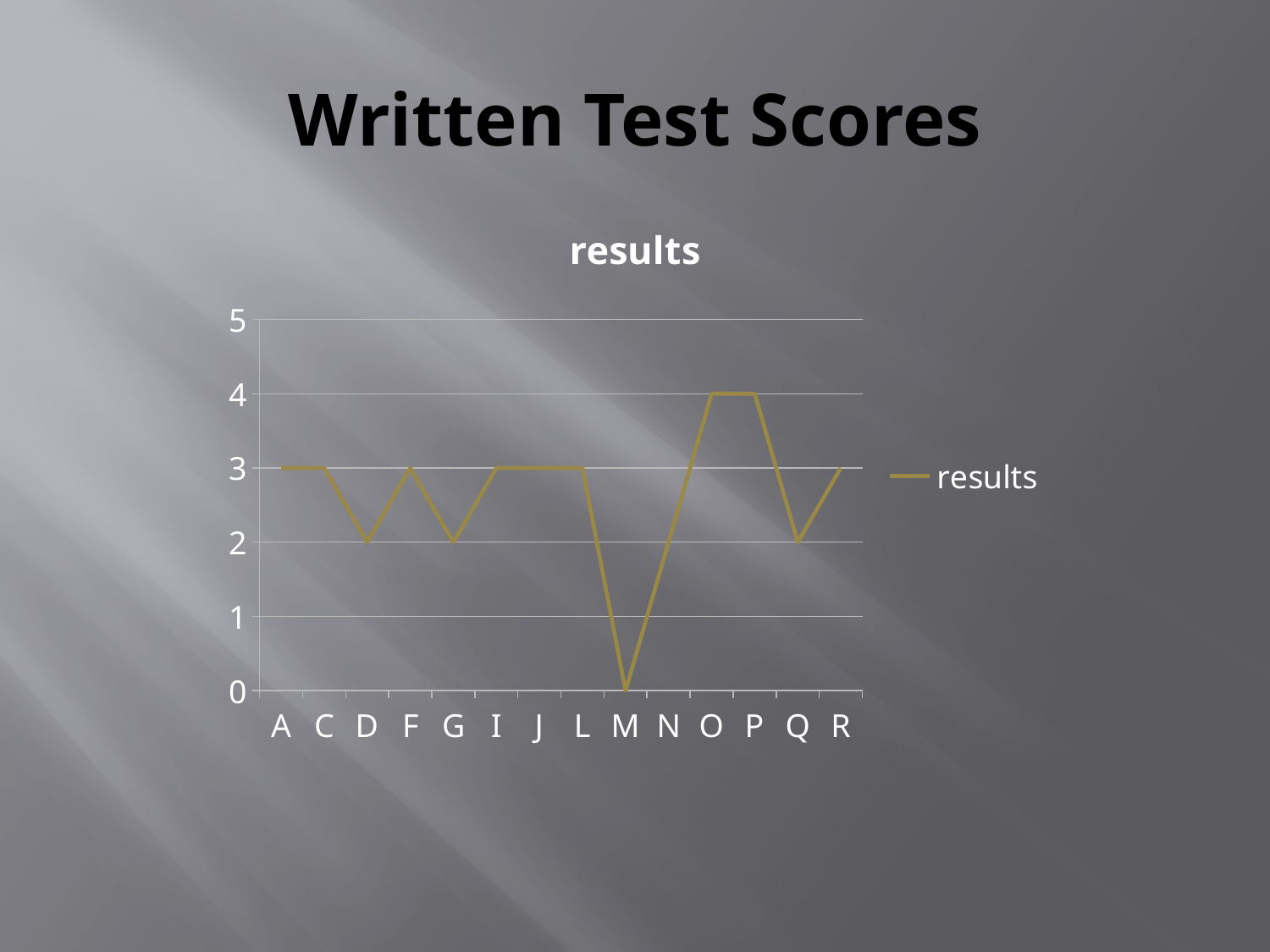
What type of chart is shown on the slide? line chart What is the title of the chart? results How many series does the legend list? 1 What is the value for O in the results chart? 4 What is the difference between the values for P and Q? 2 How many categories are shown on the x axis of the chart? 14 Which category has the lowest value in the results chart? M What is the value for M in the results chart? 0 What is the value for D in the results chart? 2 Which is larger, the value for O or the value for G? O What is the difference between the values for A and M? 3 What is the value for R in the results chart? 3